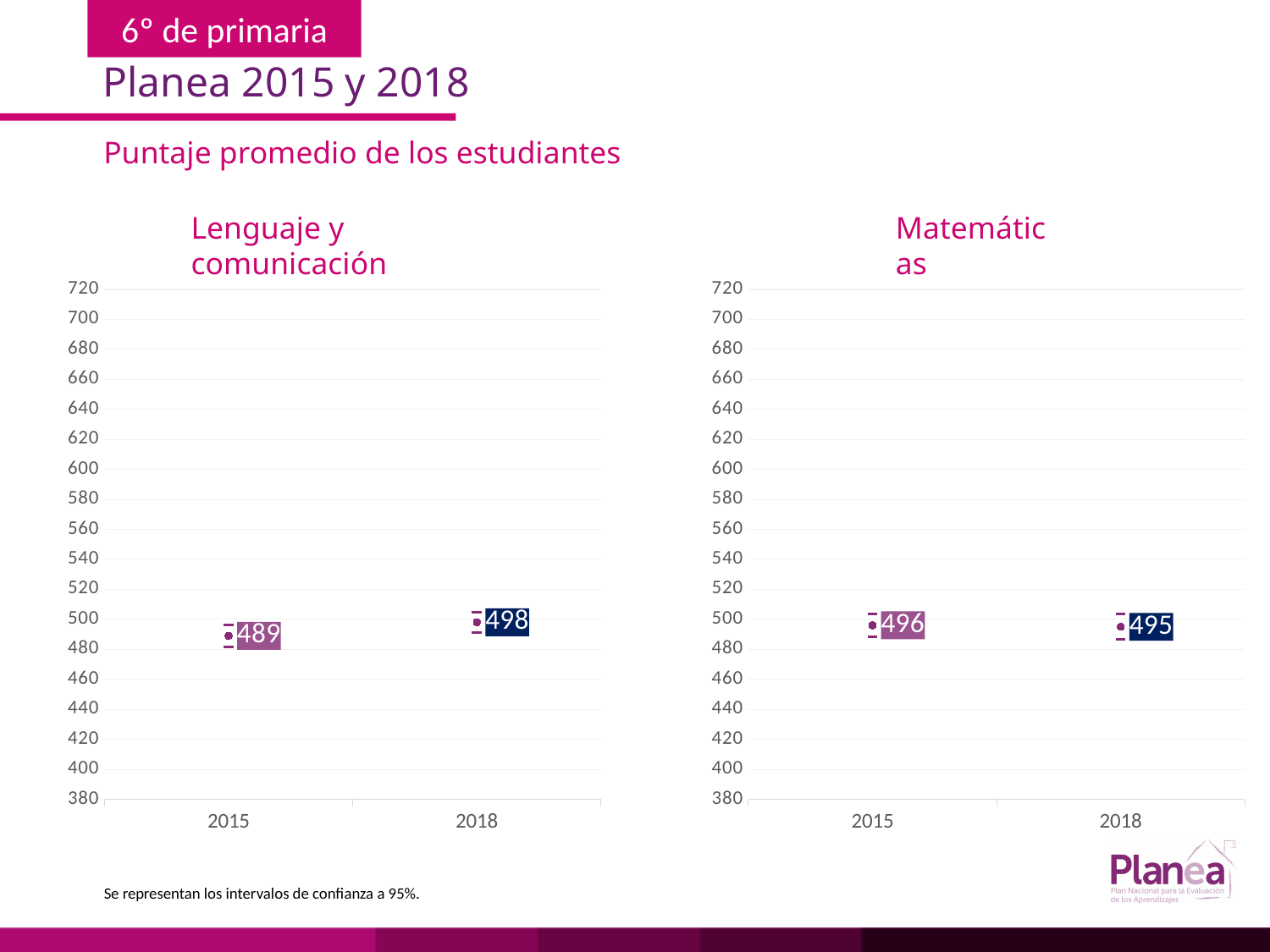
In the Matemáticas chart, what is the difference between the 2015 and 2018 values? 1 In the Lenguaje y comunicación chart, what is the value for 2015? 489 In the Lenguaje y comunicación chart, which year has the higher value? 2018 In the Lenguaje y comunicación chart, is the value for 2015 greater or less than 500? less In the Lenguaje y comunicación chart, do the values rise or fall from 2015 to 2018? rise What is the title of the chart on the right side of the slide? Matemáticas How many years are plotted in the Matemáticas chart? 2 In the Lenguaje y comunicación chart, what is the difference between the 2018 and 2015 values? 9 In the Matemáticas chart, what is the value for 2018? 495 In the Lenguaje y comunicación chart, what is the value for 2018? 498 In the Matemáticas chart, what is the value for 2015? 496 In the Matemáticas chart, which year has the lower value? 2018